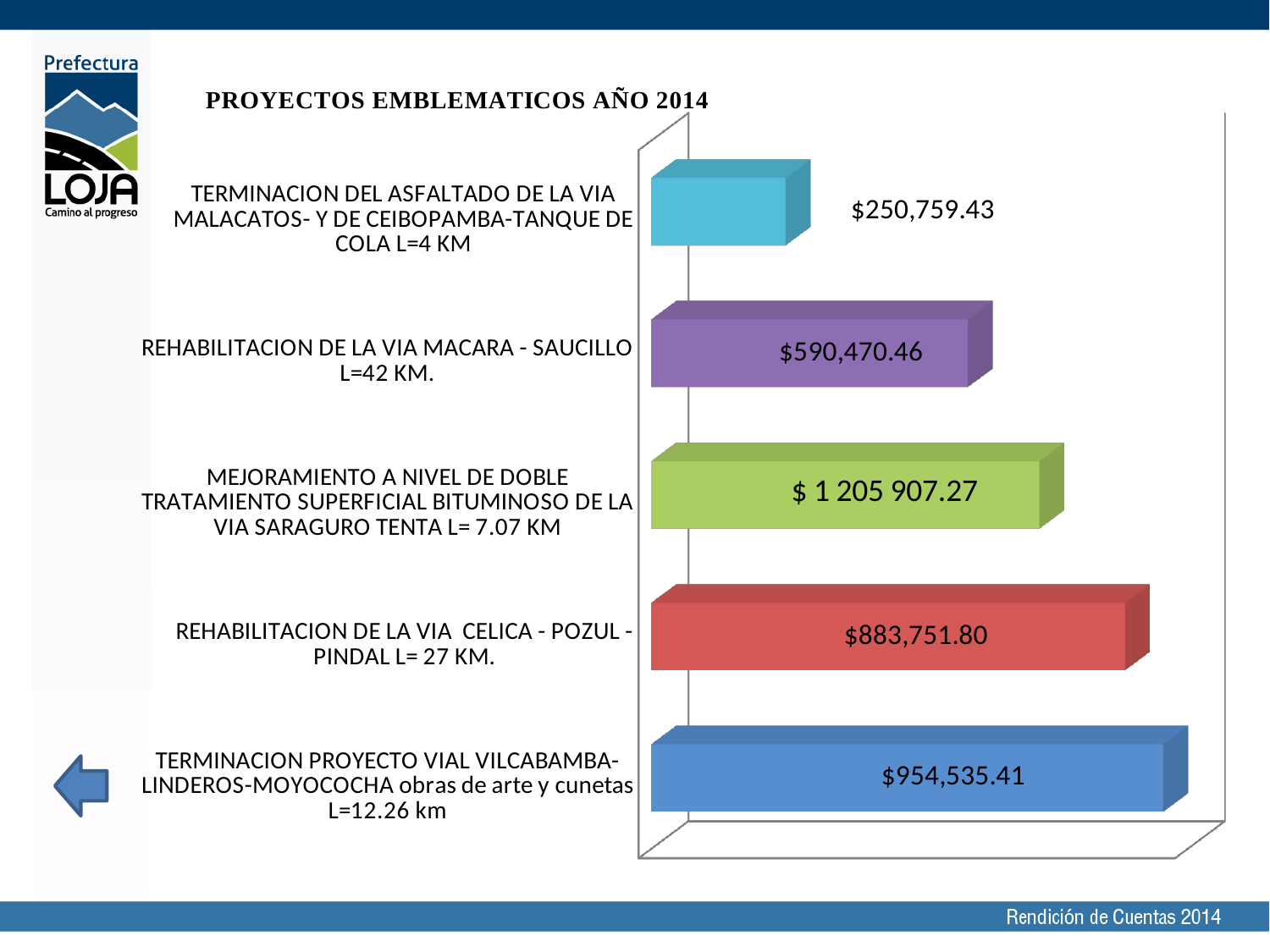
What is the value shown for MEJORAMIENTO A NIVEL DE DOBLE TRATAMIENTO SUPERFICIAL BITUMINOSO DE LA VIA SARAGURO TENTA L= 7.07 KM? $ 1 205 907.27 What type of chart is shown on the slide? Bar chart Which project has the smallest value? TERMINACION DEL ASFALTADO DE LA VIA MALACATOS- Y DE CEIBOPAMBA-TANQUE DE COLA L=4 KM Which project has the highest value according to the data labels? MEJORAMIENTO A NIVEL DE DOBLE TRATAMIENTO SUPERFICIAL BITUMINOSO DE LA VIA SARAGURO TENTA L= 7.07 KM What is the value shown for TERMINACION PROYECTO VIAL VILCABAMBA-LINDEROS-MOYOCOCHA obras de arte y cunetas L=12.26 km? $954,535.41 What is the difference between the values for the VILCABAMBA-LINDEROS-MOYOCOCHA project and the CELICA - POZUL - PINDAL project? $70,783.61 What is the value shown for TERMINACION DEL ASFALTADO DE LA VIA MALACATOS- Y DE CEIBOPAMBA-TANQUE DE COLA L=4 KM? $250,759.43 What is the value shown for REHABILITACION DE LA VIA MACARA - SAUCILLO L=42 KM.? $590,470.46 Which has a larger value: the CELICA - POZUL - PINDAL project or the VILCABAMBA-LINDEROS-MOYOCOCHA project? TERMINACION PROYECTO VIAL VILCABAMBA-LINDEROS-MOYOCOCHA obras de arte y cunetas L=12.26 km What is the difference between the values for the MACARA - SAUCILLO project and the MALACATOS / CEIBOPAMBA-TANQUE DE COLA project? $339,711.03 What is the value shown for REHABILITACION DE LA VIA CELICA - POZUL - PINDAL L= 27 KM.? $883,751.80 How many projects are shown in the chart? 5